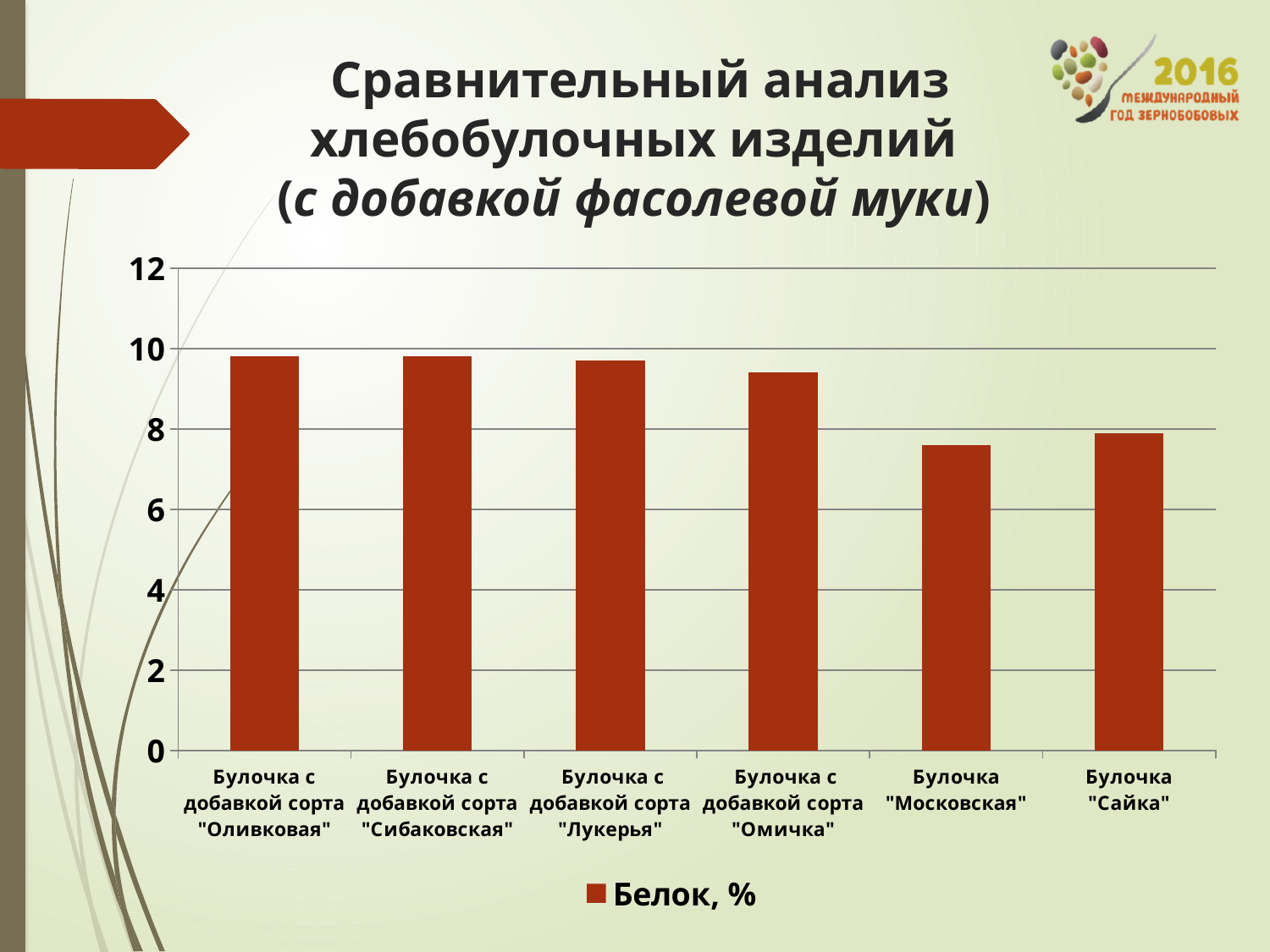
How many series does the legend list? 1 What kind of chart is shown on the slide? bar chart Which is larger: the value for Булочка с добавкой сорта "Омичка" or for Булочка "Московская"? Булочка с добавкой сорта "Омичка" What is the name of the series shown in the legend? Белок, % Do the values generally rise or fall from left to right along the x axis? fall Is the value for Булочка "Московская" greater or less than 8? less Is the value for Булочка с добавкой сорта "Лукерья" greater or less than 10? less Which category has the lowest value? Булочка "Московская" Is the value for Булочка с добавкой сорта "Омичка" greater or less than 8? greater Which is larger: the value for Булочка с добавкой сорта "Лукерья" or for Булочка "Сайка"? Булочка с добавкой сорта "Лукерья" How many categories (bread products) are shown on the x axis? 6